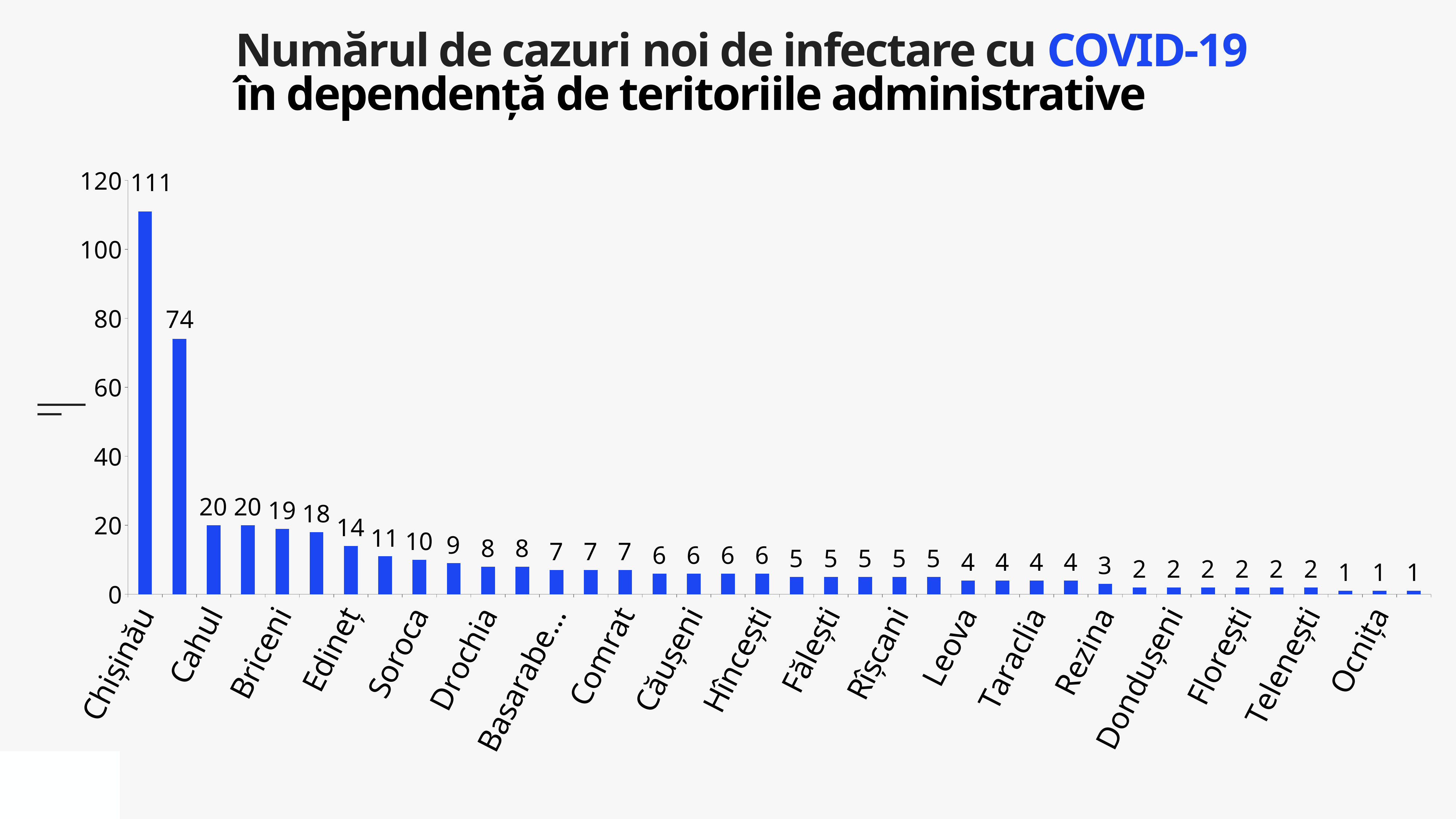
What is the value of the tallest bar? 111 Do the values rise or fall from left to right along the x axis? fall Which category has the highest value? Chișinău What is the lowest value shown on the chart? 1 What is the value for Chișinău? 111 What type of chart is shown on the slide? bar chart What is the value of the second tallest bar? 74 What is the value for Ocnița? 1 What is the highest tick value shown on the vertical axis? 120 Is the value for Chișinău greater or less than 100? greater Which is larger, the value for Chișinău or the value for Ocnița? Chișinău What is the difference between the two tallest bars? 37